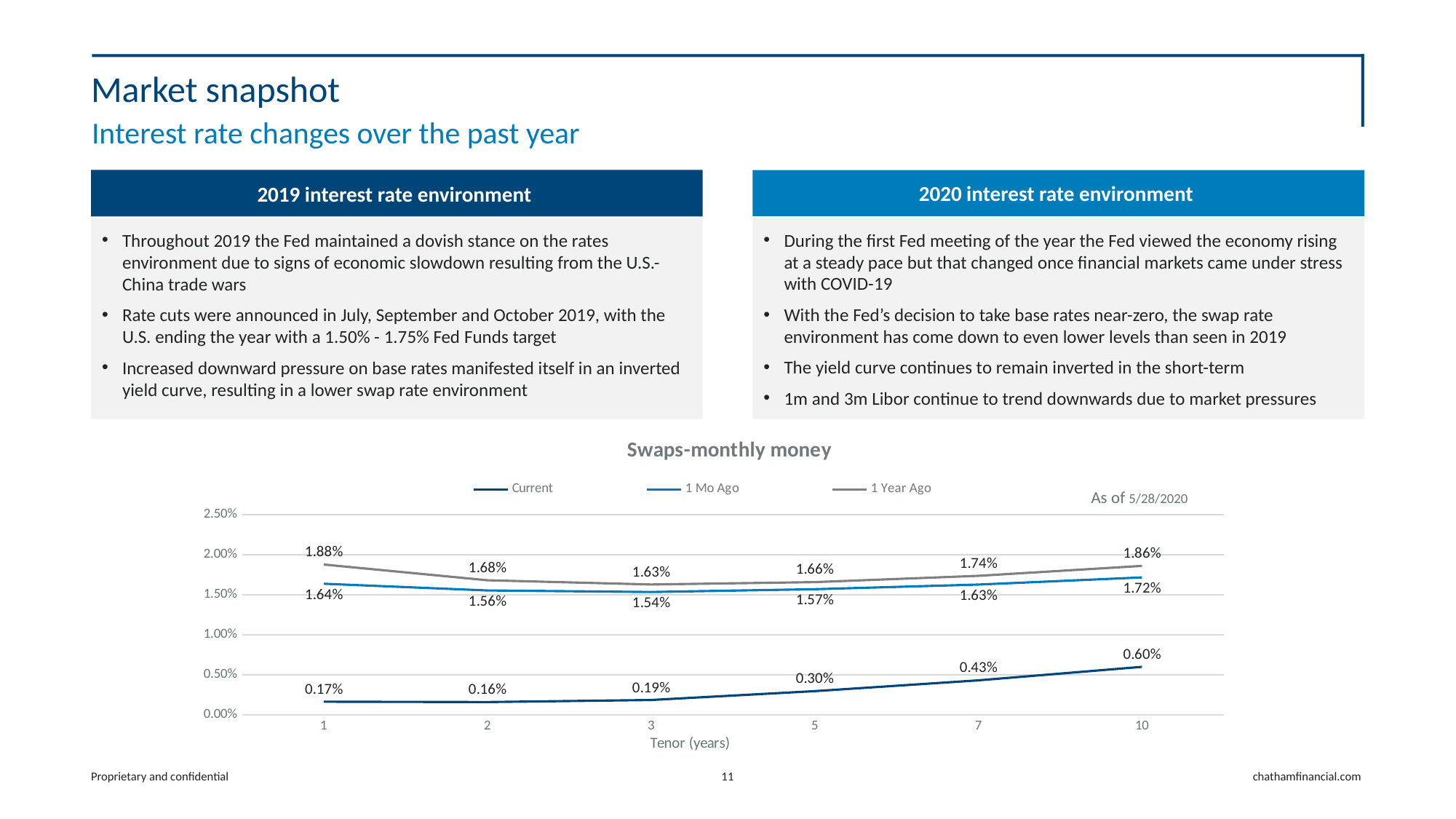
How many tenor points are plotted on the x axis of the Swaps-monthly money chart? 6 What is the 1 Mo Ago swap rate at the 3-year tenor? 1.54% At which tenor is the 1 Year Ago swap rate lowest? 3 What is the Current swap rate at the 10-year tenor? 0.60% How many series does the legend of the Swaps-monthly money chart list? 3 What is the difference between the 1 Year Ago and Current swap rates at the 5-year tenor? 1.36% What type of chart is the Swaps-monthly money chart? line chart Which is larger at the 7-year tenor: the 1 Mo Ago rate or the 1 Year Ago rate? 1 Year Ago At which tenor is the Current swap rate highest? 10 What is the 'As of' date shown on the Swaps-monthly money chart? 5/28/2020 What is the 1 Year Ago swap rate at the 1-year tenor? 1.88% Does the Current series rise or fall from the 3-year tenor to the 10-year tenor? rise